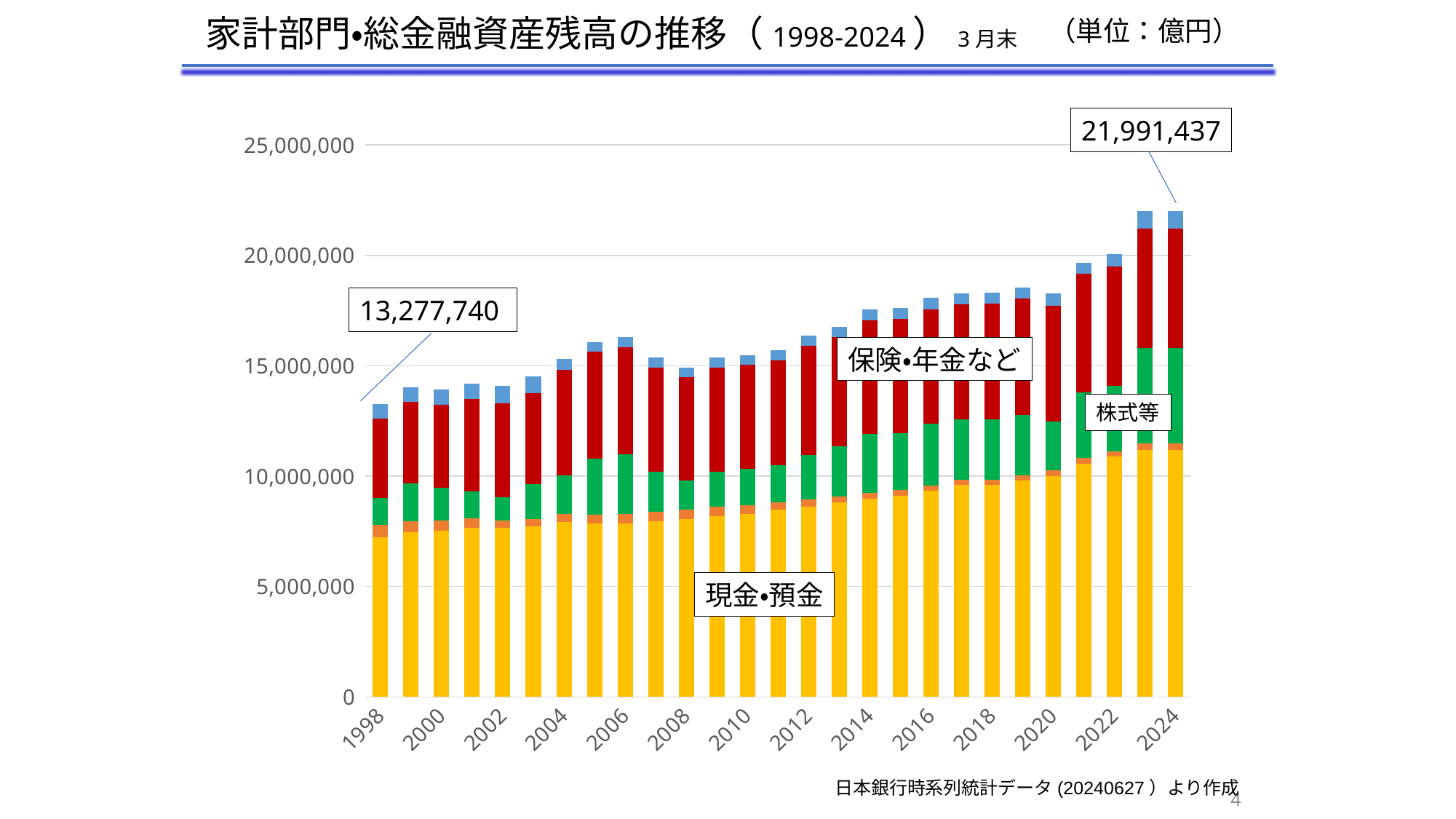
What is the difference between the 2024 total (21,991,437) and the 1998 total (13,277,740)? 8,713,697 What kind of chart is shown on the slide? Stacked bar chart Is the total for 2021 greater or less than 20,000,000? less How many years (bars) are plotted in the chart? 27 Which asset category forms the bottom (yellow) segment of each bar? 現金・預金 What is the total household financial asset balance shown for 1998? 13,277,740 What is the total household financial asset balance shown for 2024? 21,991,437 Is the total for 2016 greater or less than 15,000,000? greater Do the total balances generally rise or fall from 1998 to 2024? rise What unit is stated for the values in the chart? 億円 Which year has the larger total, 2020 or 2021? 2021 Which year has the lowest total financial asset balance? 1998